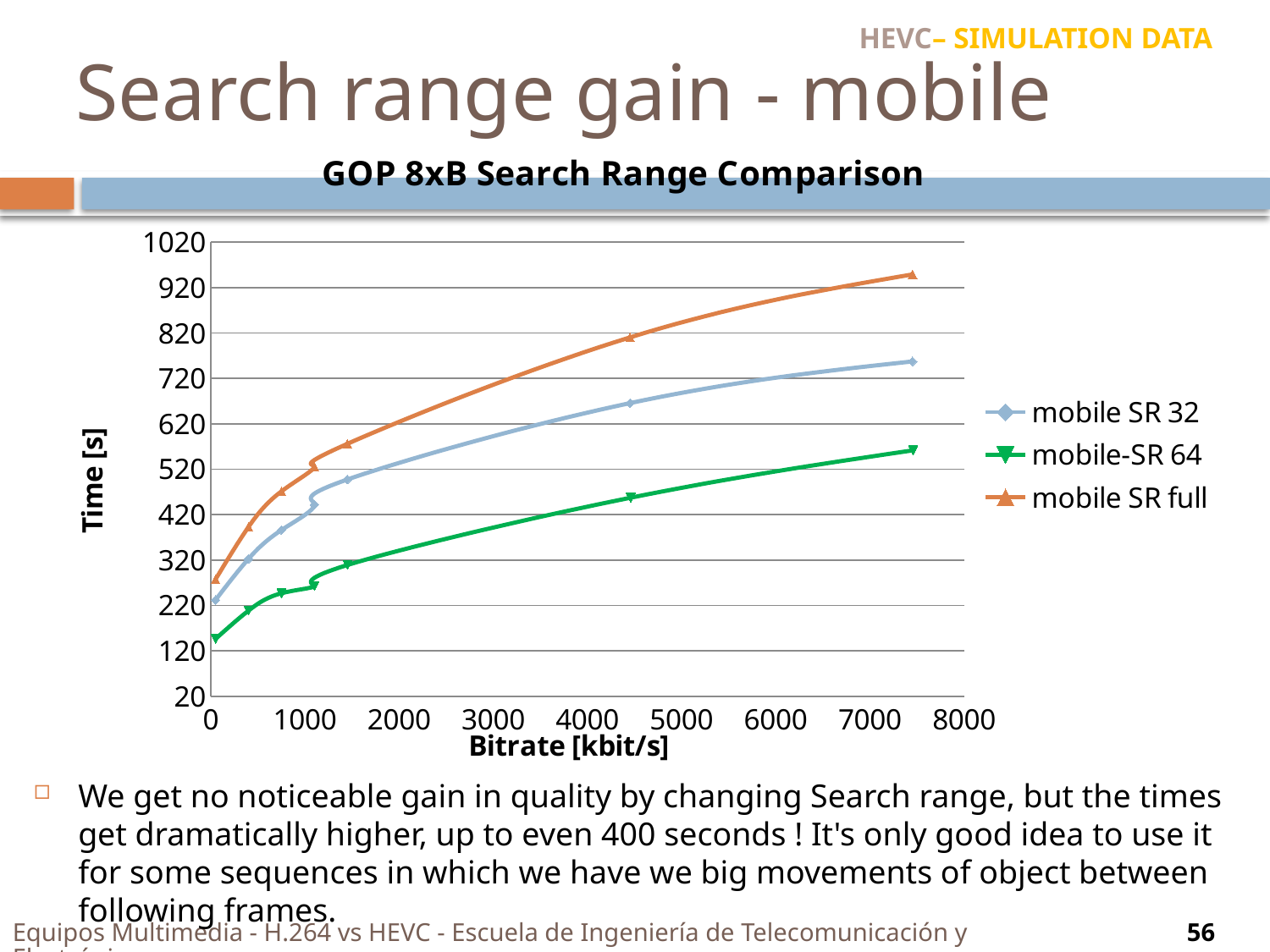
Which series has the lowest time values across the bitrate range? mobile-SR 64 At the highest plotted bitrate, is the time for mobile SR 32 greater or less than 720? greater What kind of chart is shown on the slide? line chart How many series does the legend list? 3 Which series has the highest time values across the bitrate range? mobile SR full At a bitrate of about 4500 kbit/s, is the time for mobile-SR 64 greater or less than 520? less What is the title of the chart? GOP 8xB Search Range Comparison At the highest plotted bitrate, is the time for mobile-SR 64 greater or less than 620? less Do the time values rise or fall as bitrate increases? rise At the highest plotted bitrate, which series has the larger time: mobile SR 32 or mobile-SR 64? mobile SR 32 What is the label of the vertical axis? Time [s]